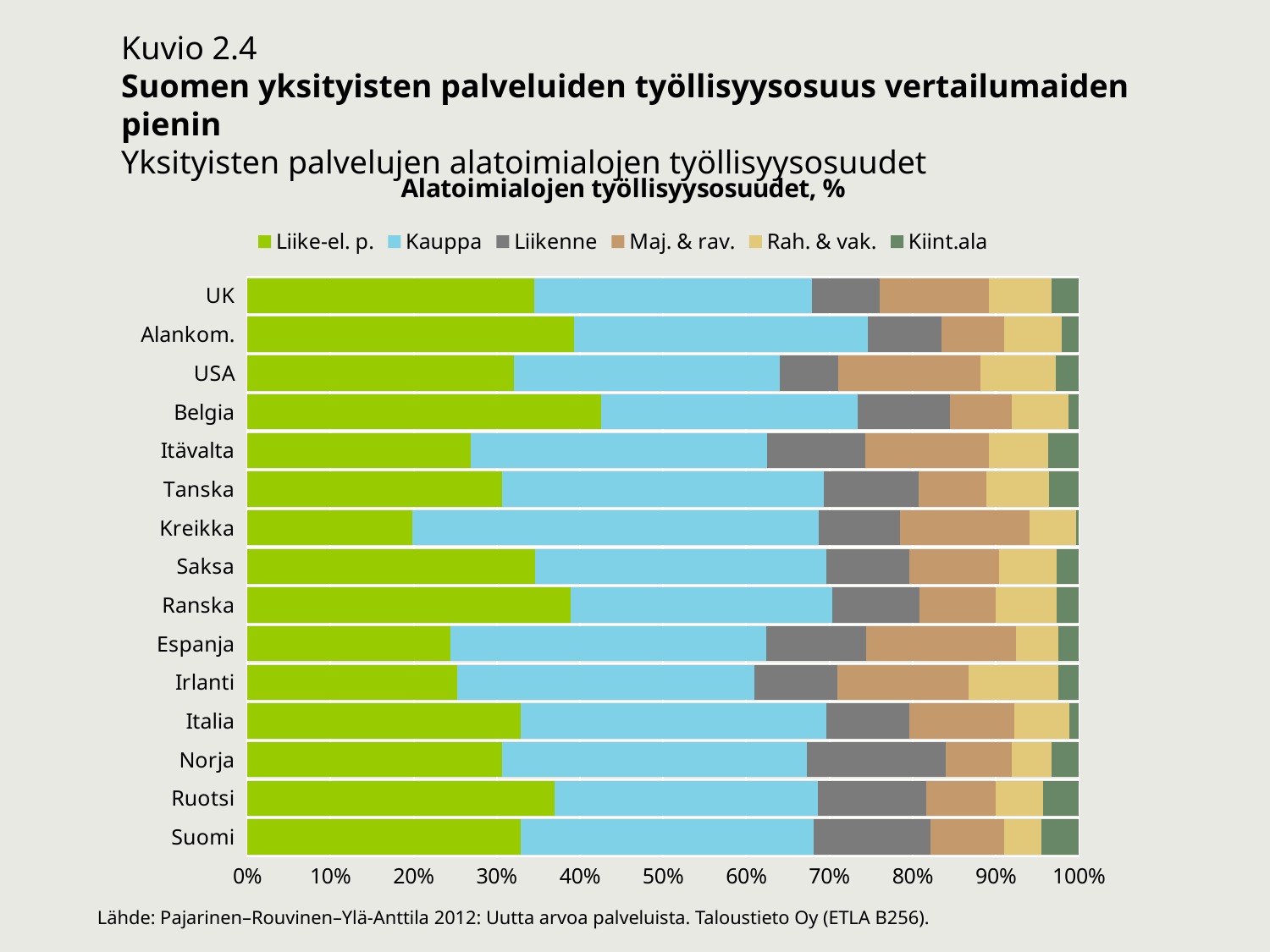
Which series is listed first in the chart legend? Liike-el. p. Is the Liike-el. p. share for Kreikka greater or less than 30%? less Is the Liike-el. p. share for Alankom. greater or less than 30%? greater Which country has the largest Kauppa segment? Kreikka What kind of chart is shown on the slide? Stacked bar chart Which country has a larger Liike-el. p. segment, Belgia or Espanja? Belgia What value does each country's stacked bar total on the horizontal axis? 100% Which country has the largest Liike-el. p. segment? Belgia How many series does the chart legend list? 6 How many countries are listed on the vertical axis of the chart? 15 Which country has the smallest Liike-el. p. segment? Kreikka What is the title printed above the chart legend? Alatoimialojen työllisyysosuudet, %